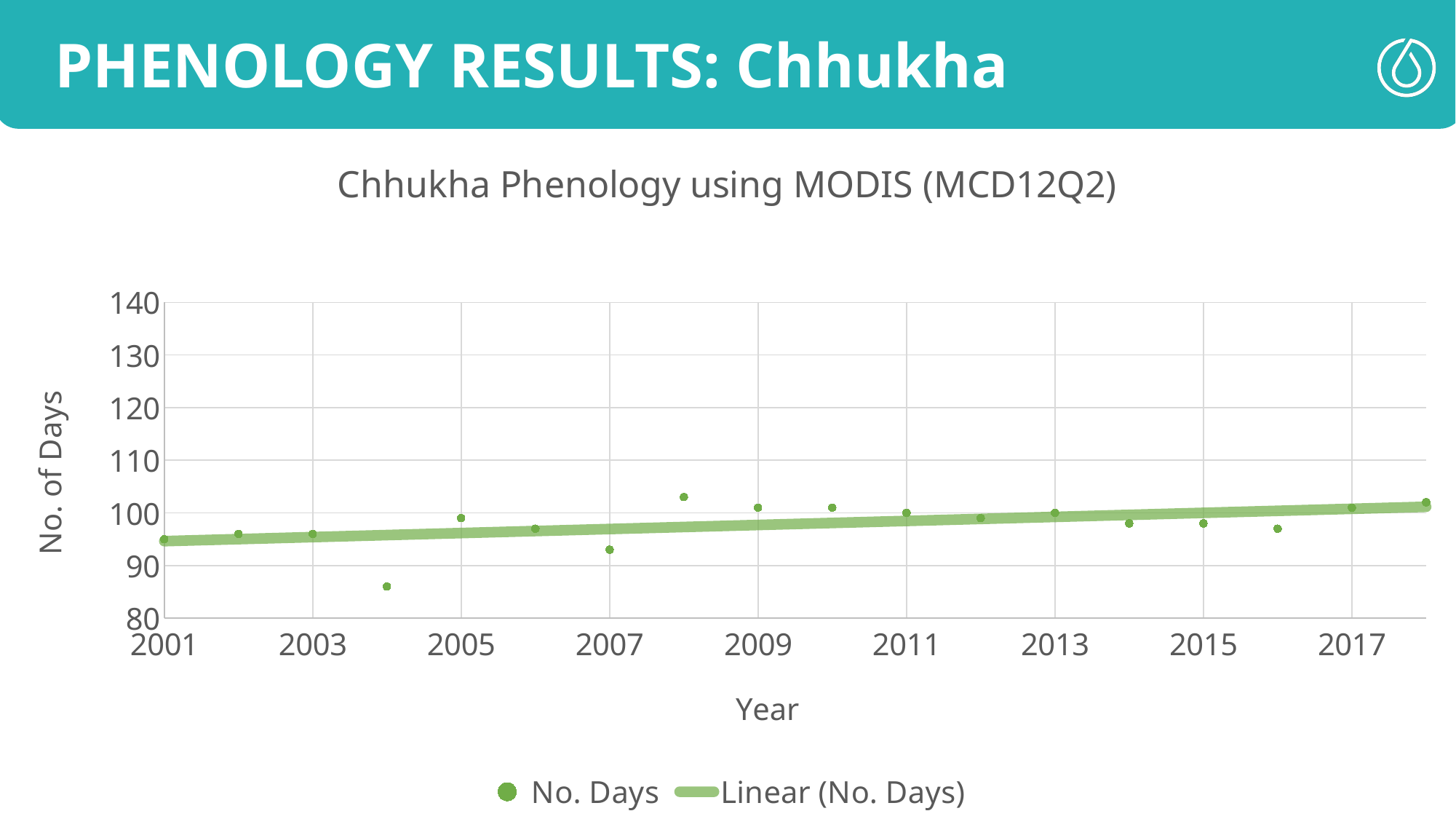
Which year has the lowest number of days? 2004 Is the value for 2007 greater or less than 100? less How many data points are plotted for No. Days? 18 What is the title of the chart? Chhukha Phenology using MODIS (MCD12Q2) Is the value for 2008 greater or less than 100? greater What is the label of the y axis? No. of Days Does the linear trendline rise or fall from 2001 to 2018? rise How many series does the legend list? 2 Is the value for 2004 greater or less than 90? less What kind of chart is shown on the slide? Scatter chart Which year has the larger number of days, 2004 or 2008? 2008